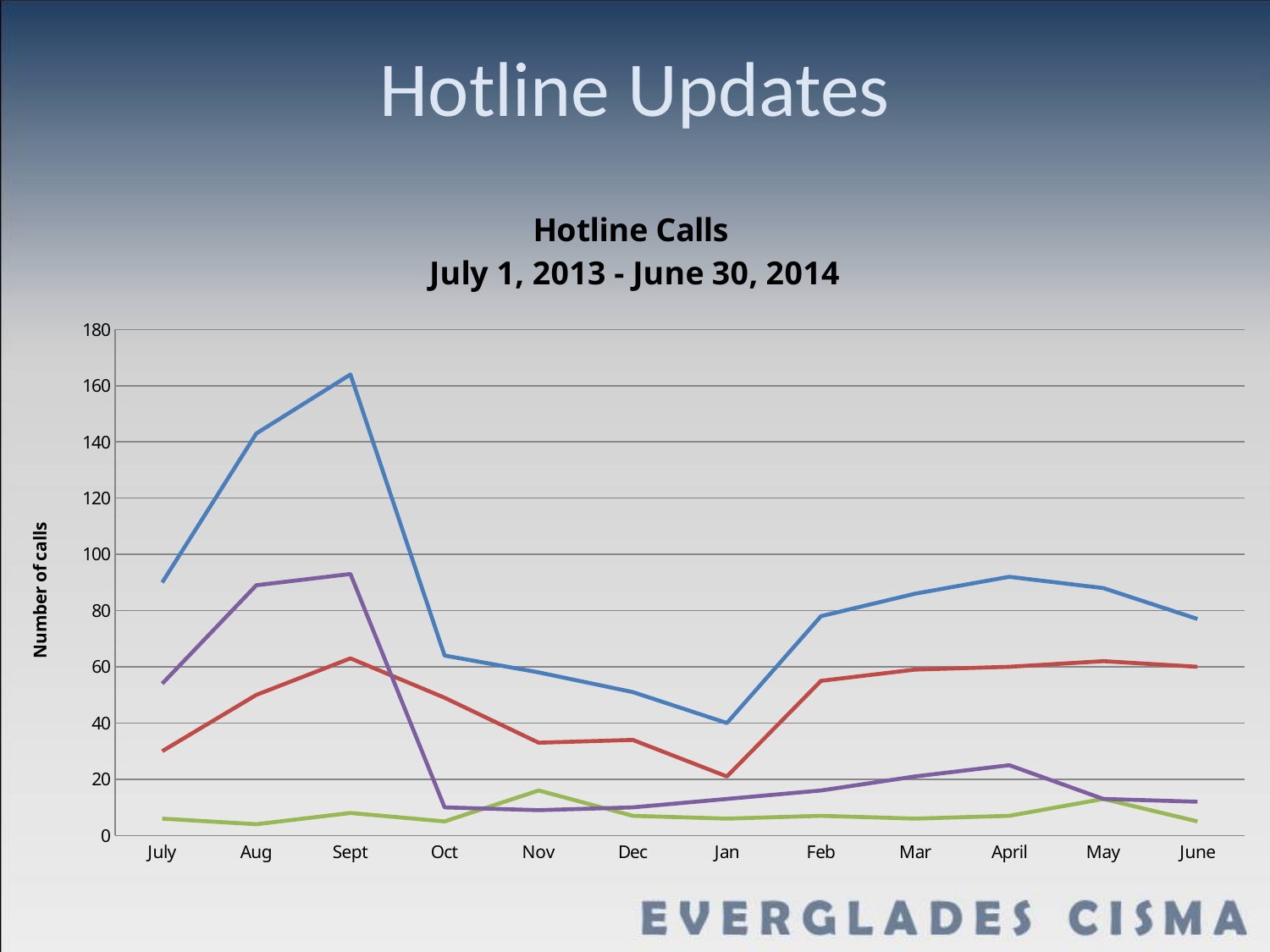
What type of chart is shown on the slide? line chart How many months are shown along the x axis of the chart? 12 In which month does the blue line reach its highest value? Sept Does the blue line rise or fall from Sept to Oct? fall What is the label on the vertical axis of the chart? Number of calls Is the value of the purple line in Oct greater or less than 20? less Is the value of the blue line in Sept greater or less than 160? greater In which month does the blue line reach its lowest value? Jan What is the title of the chart? Hotline Calls July 1, 2013 - June 30, 2014 How many lines are plotted on the chart? 4 In which month does the purple line reach its highest value? Sept Which line has the higher value in July, the blue line or the red line? blue line